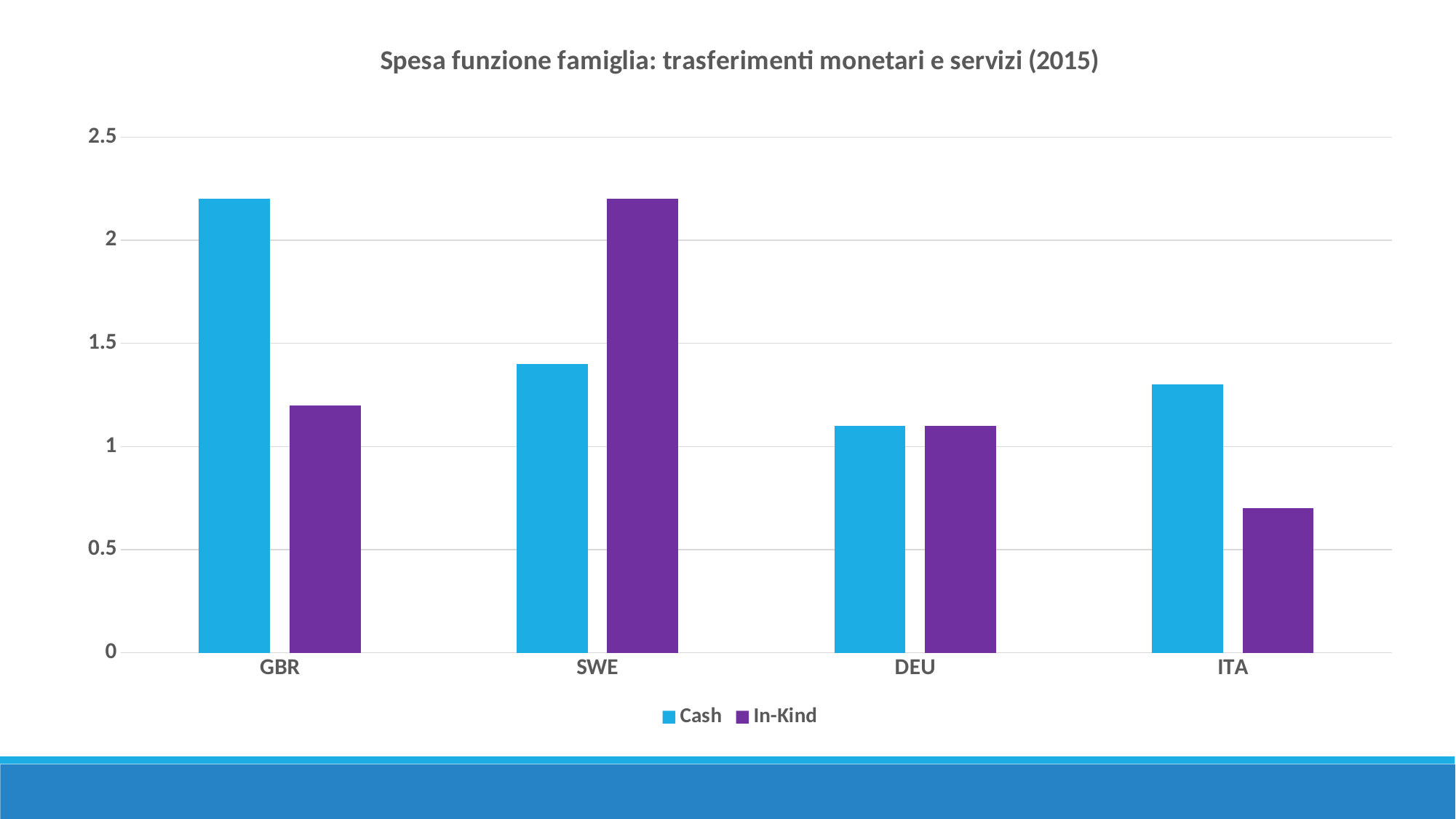
Is the In-Kind value for ITA greater or less than 1? less Is the Cash value for GBR greater or less than 2? greater How many countries are shown on the x axis? 4 Which country has the highest Cash value? GBR How many series does the legend list? 2 Which country has the lowest Cash value? DEU Which country has the lowest In-Kind value? ITA Which country has the highest In-Kind value? SWE Is the Cash value for SWE greater or less than 1.5? less For ITA, which is larger, the Cash value or the In-Kind value? Cash What kind of chart is shown on the slide? bar chart What is the title of the chart? Spesa funzione famiglia: trasferimenti monetari e servizi (2015)